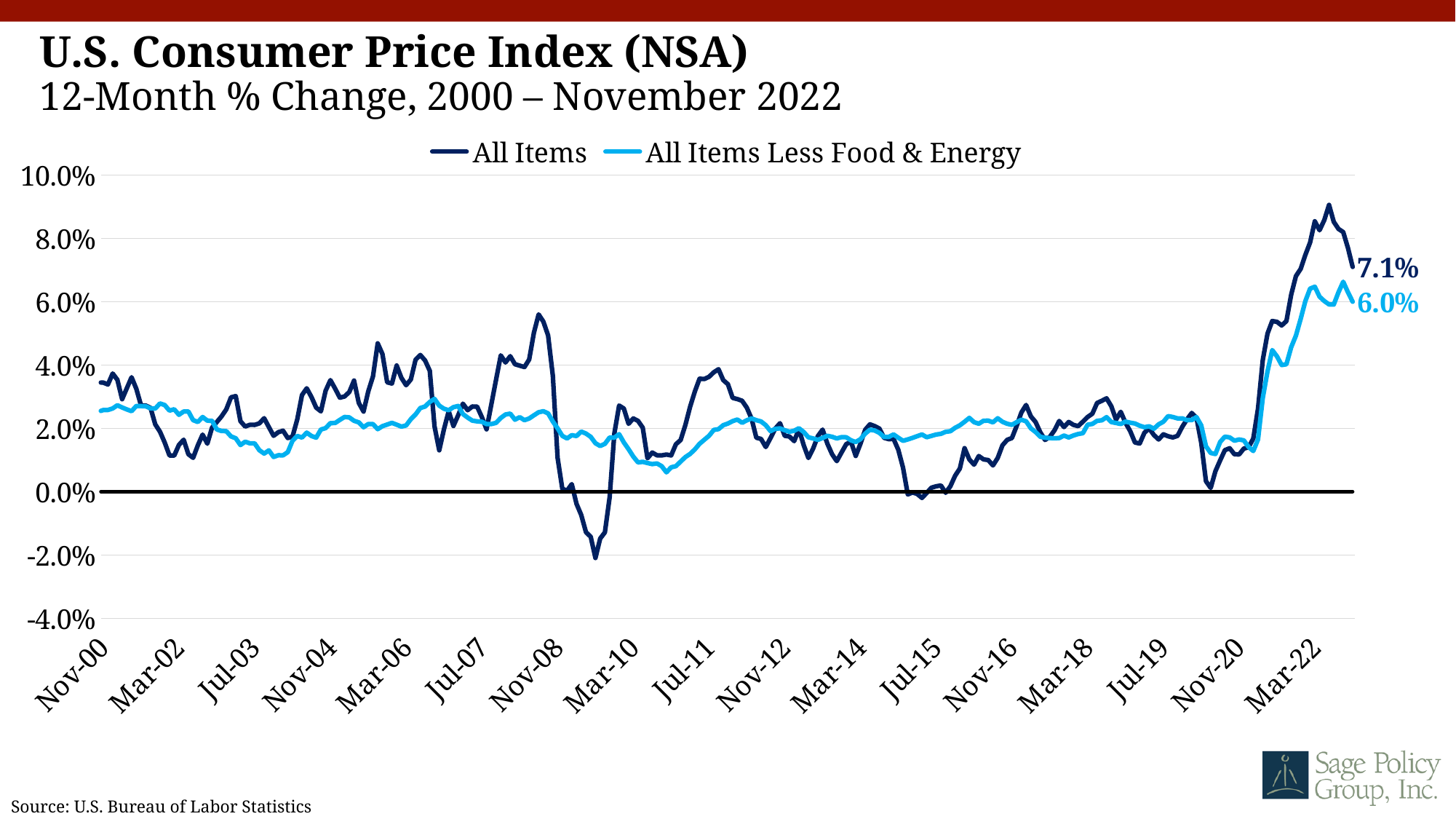
How many series does the legend list? 2 At the end of the chart, which series has the higher value: All Items or All Items Less Food & Energy? All Items What kind of chart is shown on the slide? Line chart Does the All Items Less Food & Energy series ever fall below 0.0% on the chart? No What is the difference between the final labelled values of All Items (7.1%) and All Items Less Food & Energy (6.0%)? 1.1 percentage points Between Nov-20 and Mar-22, does the All Items series rise or fall? Rise What is the source cited for the chart data? U.S. Bureau of Labor Statistics What is the labelled value of the All Items Less Food & Energy series at the end of the chart? 6.0% What is the labelled value of the All Items series at the end of the chart (November 2022)? 7.1% Around early 2009, is the lowest value of the All Items series greater or less than -1.0%? less Is the peak value of the All Items series in 2022 greater or less than 8.0%? greater Which series reaches the highest value anywhere on the chart? All Items